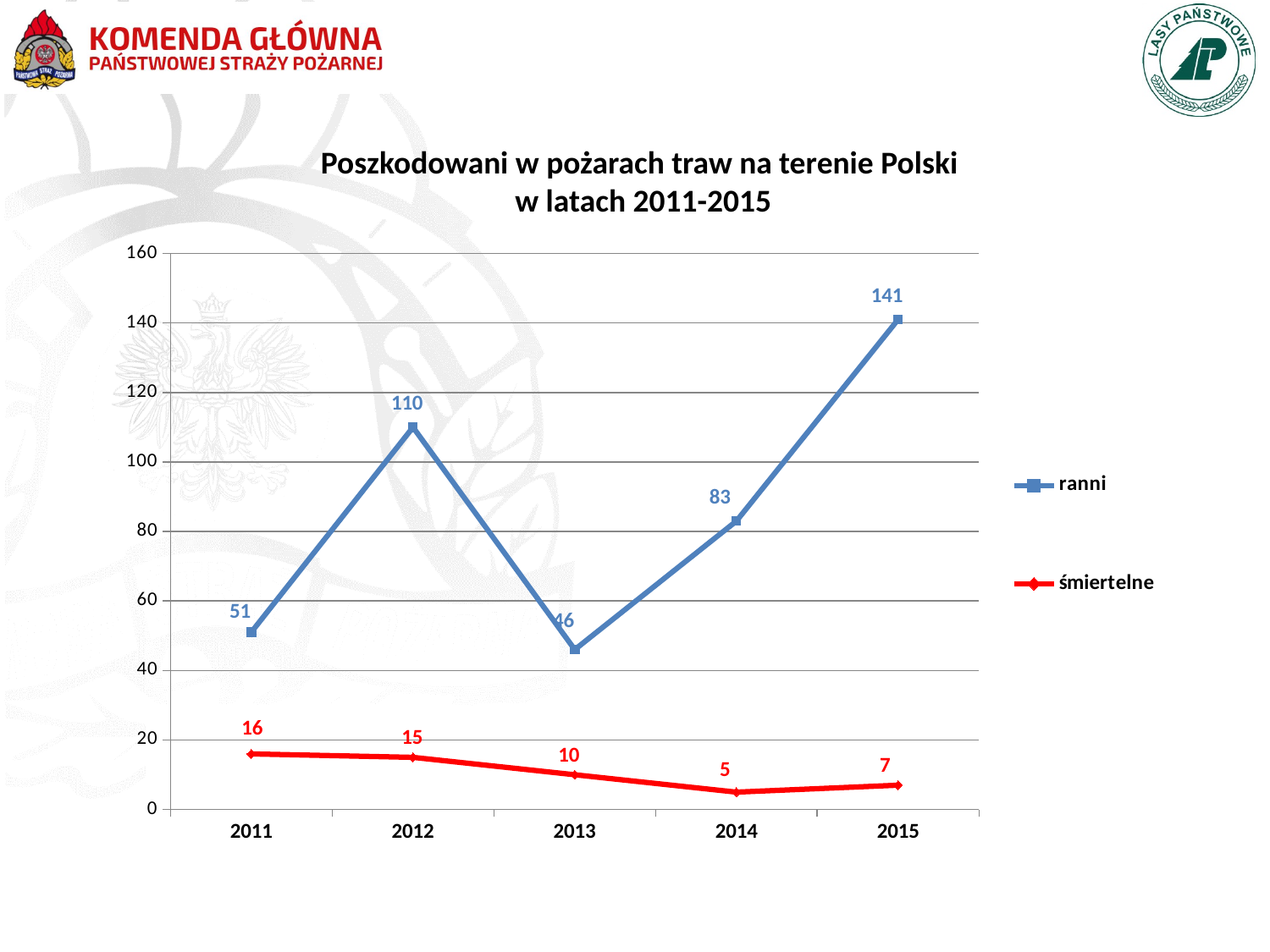
How many years are shown on the x axis? 5 Which is larger: the 'ranni' value in 2011 or in 2013? 2011 How many series does the legend list? 2 What colour is the 'śmiertelne' line? red In which year was the 'śmiertelne' value lowest? 2014 What was the value for 'ranni' in 2012? 110 What is the difference between the 'ranni' values in 2015 and 2014? 58 What was the value for 'śmiertelne' in 2014? 5 What kind of chart is shown on the slide? line chart Is the 'ranni' value for 2014 greater or less than 80? greater Did the 'śmiertelne' values rise or fall from 2011 to 2014? fall In which year was the 'ranni' value highest? 2015